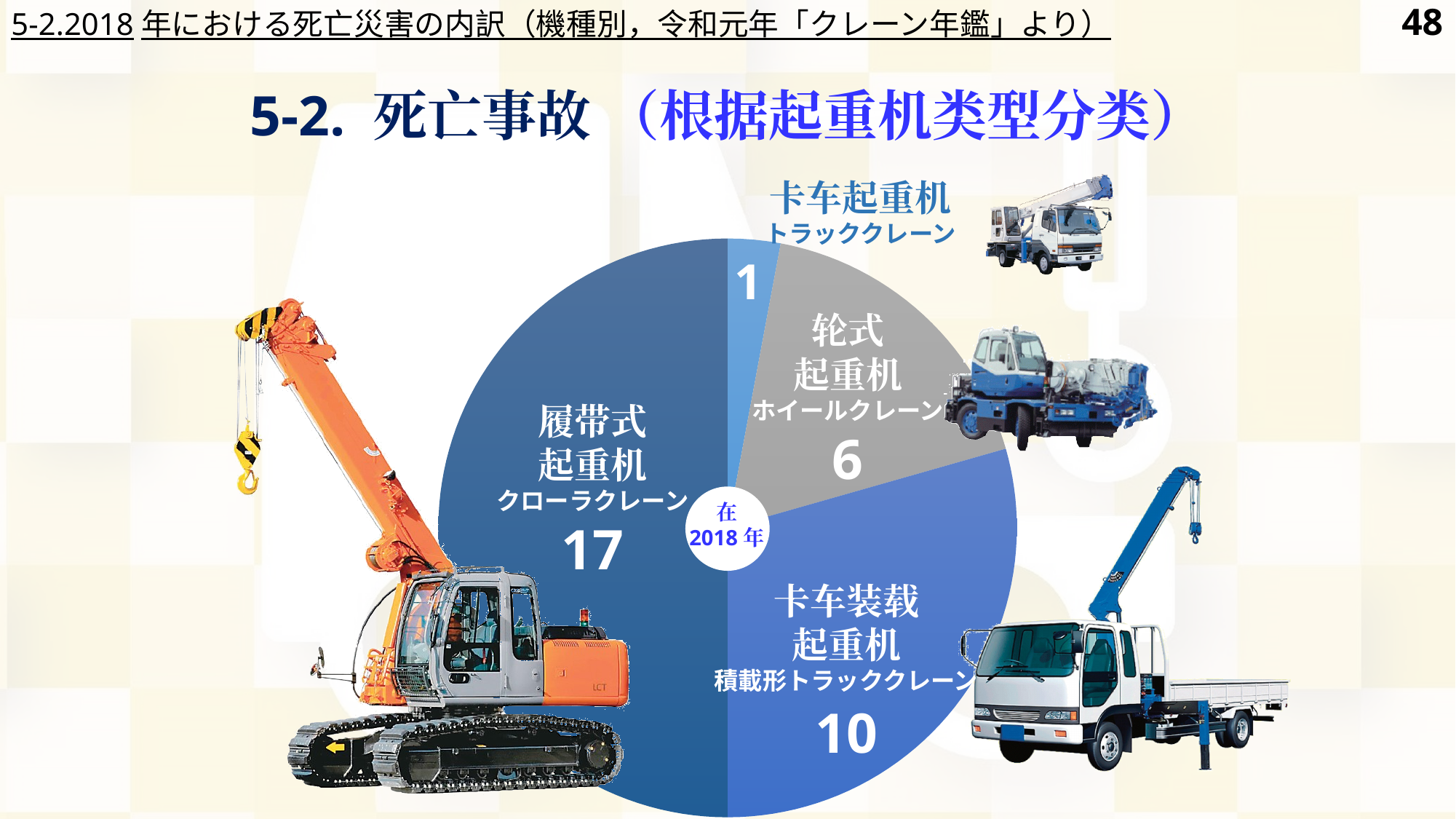
How many slices does the pie chart have? 4 What year is shown in the centre of the pie chart? 2018 What is the value for 卡车起重机 (truck crane) in the pie chart? 1 What is the value for 履带式起重机 (crawler crane) in the pie chart? 17 Which crane type has the smallest slice in the pie chart? 卡车起重机 (truck crane) What is the difference between the values for 履带式起重机 (crawler crane) and 卡车装载起重机 (truck-loader crane)? 7 Which crane type has the largest slice in the pie chart? 履带式起重机 (crawler crane) Which is larger, the value for 轮式起重机 (wheel crane) or 卡车装载起重机 (truck-loader crane)? 卡车装载起重机 (truck-loader crane) What is the value for 轮式起重机 (wheel crane) in the pie chart? 6 What is the total of all slices in the pie chart? 34 What kind of chart is shown on the slide? pie chart What is the value for 卡车装载起重机 (truck-loader crane) in the pie chart? 10